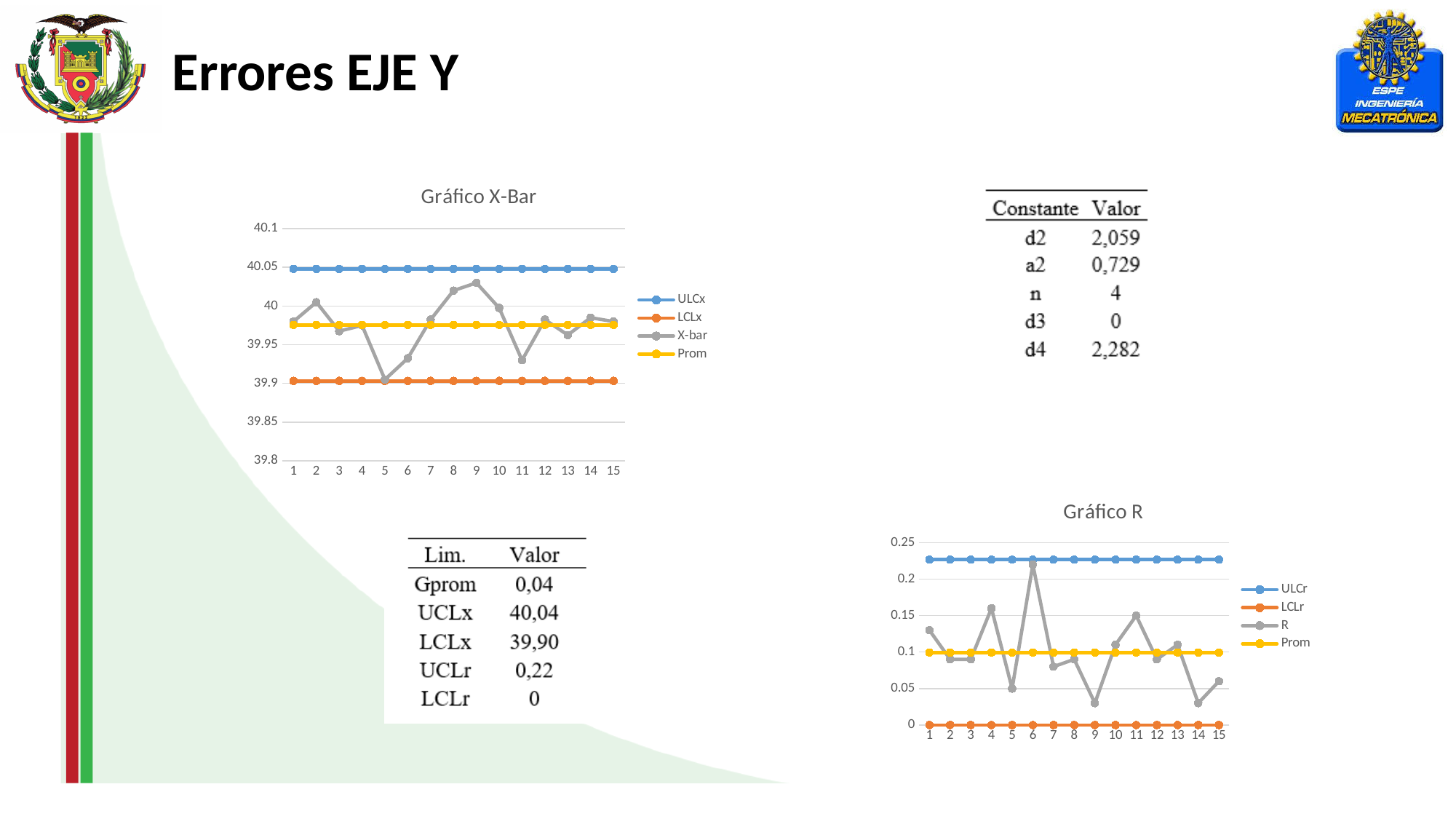
In the Gráfico X-Bar chart, is the X-bar value at point 5 greater or less than 39.95? less In the Gráfico X-Bar chart, at which x-axis point does the X-bar series reach its lowest value? 5 In the Gráfico R chart, at which x-axis point does the R series reach its highest value? 6 What kind of chart is the Gráfico X-Bar chart? line chart In the Gráfico R chart, what is the value of the LCLr series? 0 In the Gráfico R chart, is the R value at point 6 greater or less than 0.2? greater In the Gráfico X-Bar chart, is the X-bar value at point 9 greater or less than 40? greater How many points are plotted along the x axis of the Gráfico X-Bar chart? 15 How many series does the legend of the Gráfico R chart list? 4 In the Gráfico X-Bar chart, at which x-axis point does the X-bar series reach its highest value? 9 What are the legend entries of the Gráfico X-Bar chart? ULCx, LCLx, X-bar, Prom